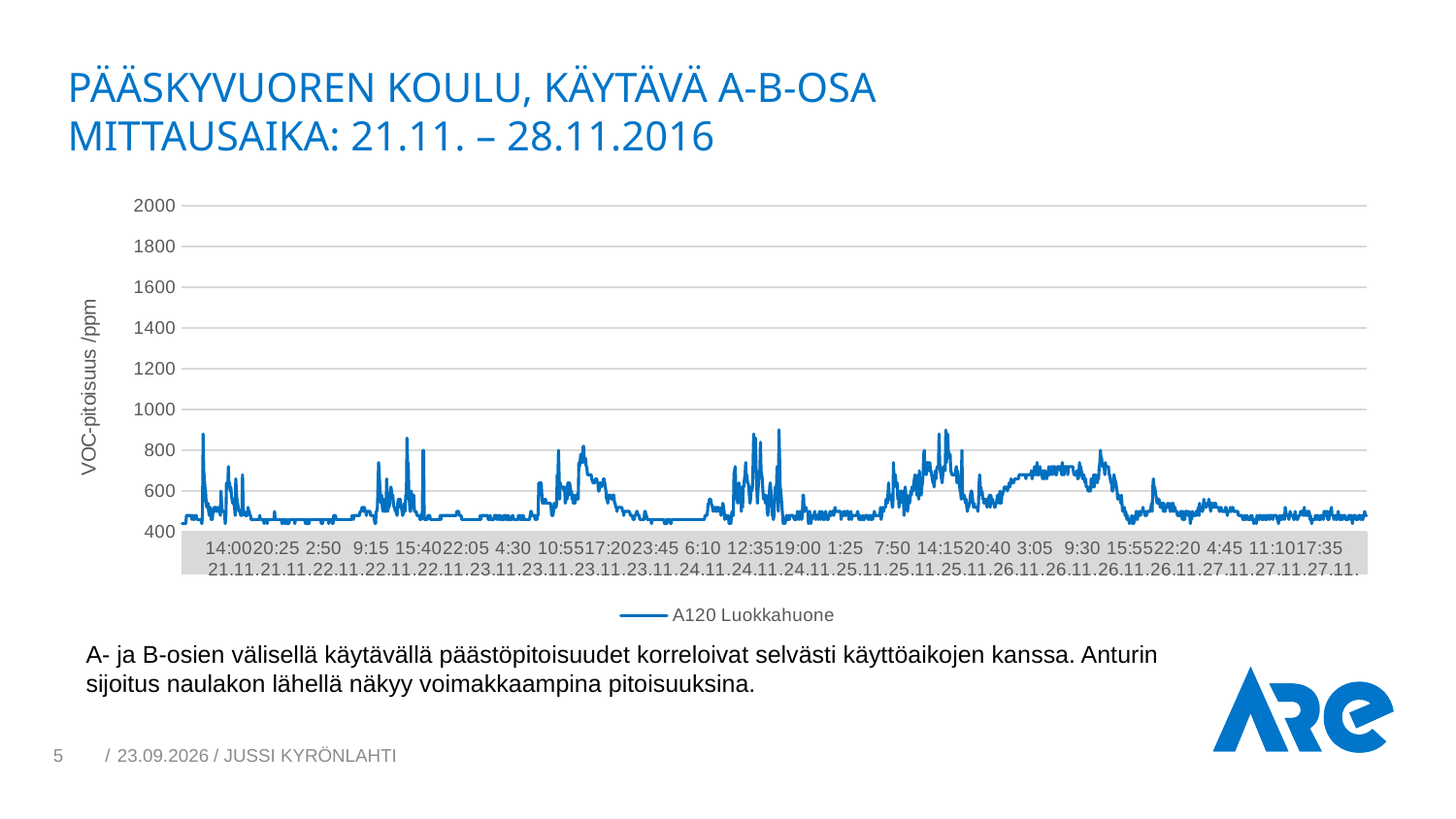
What is the name of the series shown in the chart legend? A120 Luokkahuone Does the A120 Luokkahuone line ever rise above 1200 on the vertical axis? No What is the label of the vertical axis of the chart? VOC-pitoisuus /ppm How many series does the chart legend list? 1 What is the lowest value shown on the vertical axis of the chart? 400 What is the highest value shown on the vertical axis of the chart? 2000 Is the highest value reached by the A120 Luokkahuone line greater or less than 1000? less Is the highest peak of the A120 Luokkahuone line greater or less than 800? greater What kind of chart is shown on the slide? line chart What is the interval between consecutive tick marks on the vertical axis? 200